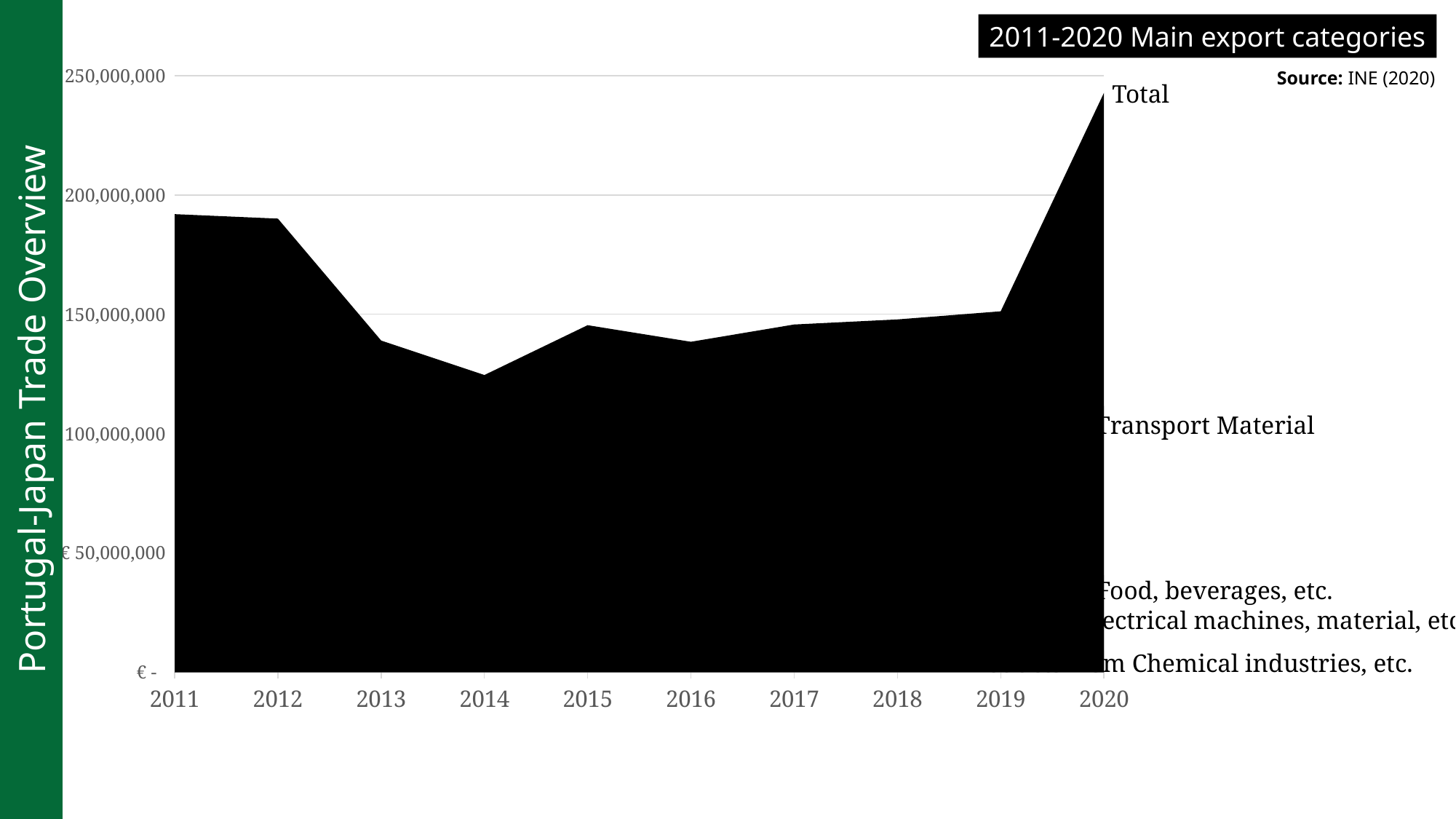
How many years are shown on the x axis of the chart? 10 Is the Total value for 2020 greater or less than 200,000,000? greater Is the Total value for 2016 greater or less than 150,000,000? less In which year is the Total value highest? 2020 Is the Total value for 2011 greater or less than 150,000,000? greater Does the Total value rise or fall from 2019 to 2020? rise What kind of chart is shown on the slide? Area chart Which year has the larger Total value, 2011 or 2014? 2011 What source is cited for the chart? INE (2020) In which year is the Total value lowest? 2014 What is the title of the chart? 2011-2020 Main export categories